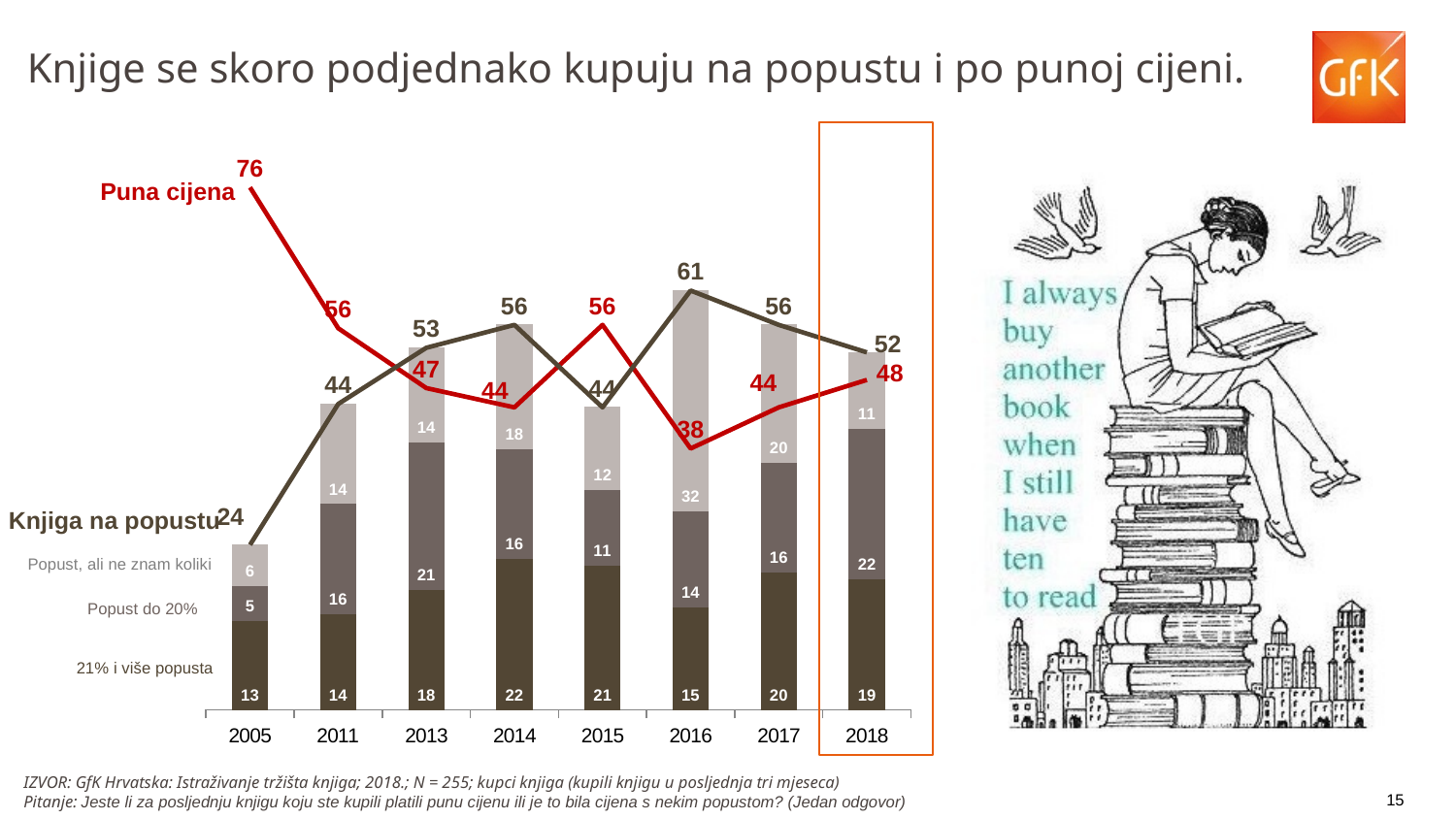
What is the value of the Puna cijena line for 2005? 76 In which year is the Puna cijena line at its lowest? 2016 What kind of chart is shown on the slide? Combined stacked bar and line chart What is the total of the stacked bar for 2013? 53 Which is larger in 2018, Puna cijena or Knjiga na popustu? Knjiga na popustu What is the value of the Knjiga na popustu line for 2018? 52 What is the value of the '21% i više popusta' segment for 2014? 22 In which year is the Knjiga na popustu line at its highest? 2016 What is the value of the 'Popust, ali ne znam koliki' segment for 2016? 32 What is the difference between the Puna cijena values for 2005 and 2018? 28 In which year is the Puna cijena line at its highest? 2005 How many years are shown on the x axis? 8